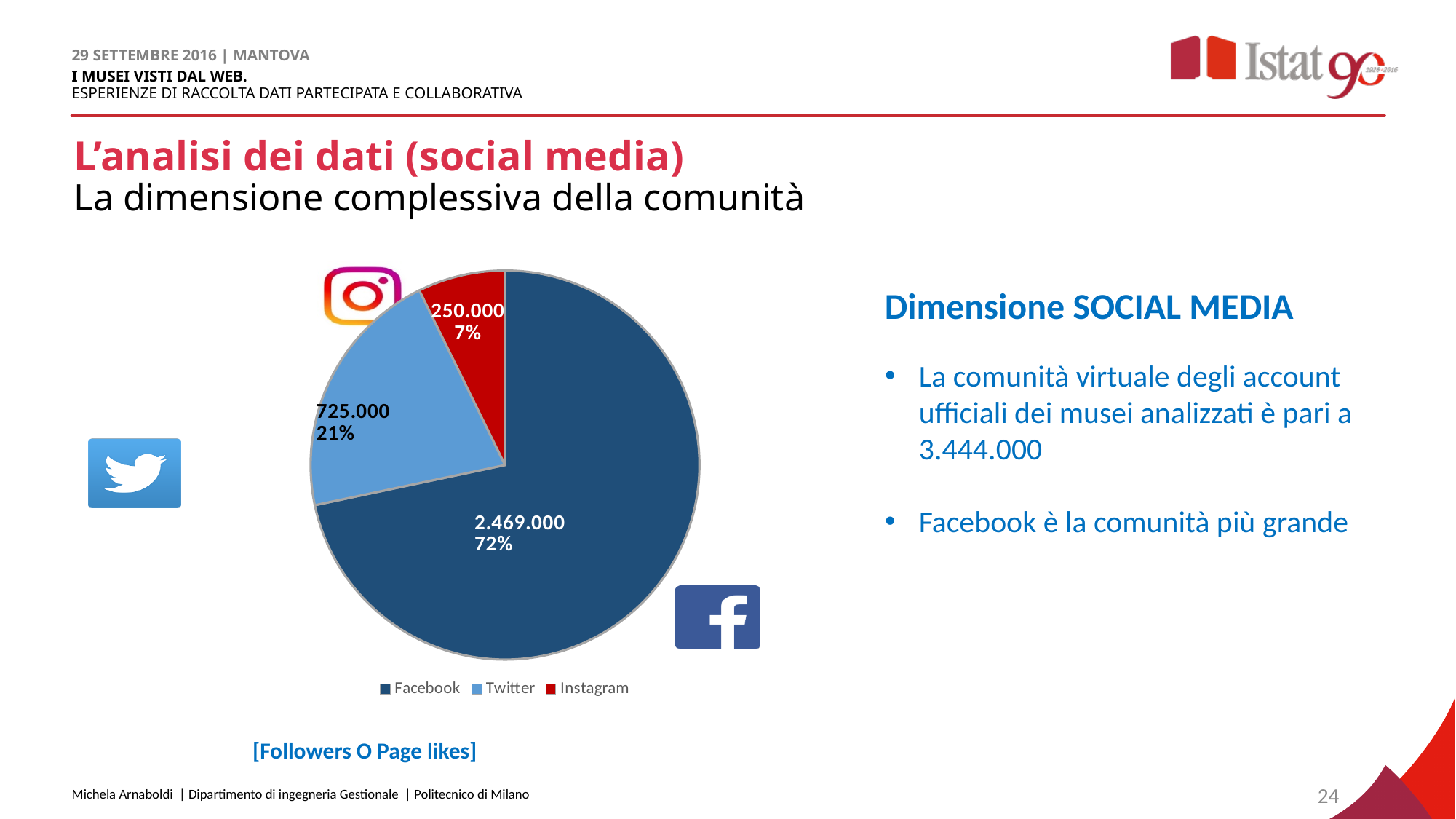
What is the value for Facebook in the pie chart? 2.469.000 What is the value for Twitter in the pie chart? 725.000 What is the difference between the Facebook value and the Twitter value? 1.744.000 Which social media platform has the smallest slice of the pie? Instagram How many categories does the legend of the pie chart list? 3 What kind of chart is shown on the slide? pie chart What share of the pie does Facebook represent? 72% Which social media platform has the largest slice of the pie? Facebook What is the value for Instagram in the pie chart? 250.000 What share of the pie does Instagram represent? 7% What share of the pie does Twitter represent? 21% Which is larger, the value for Twitter or the value for Instagram? Twitter